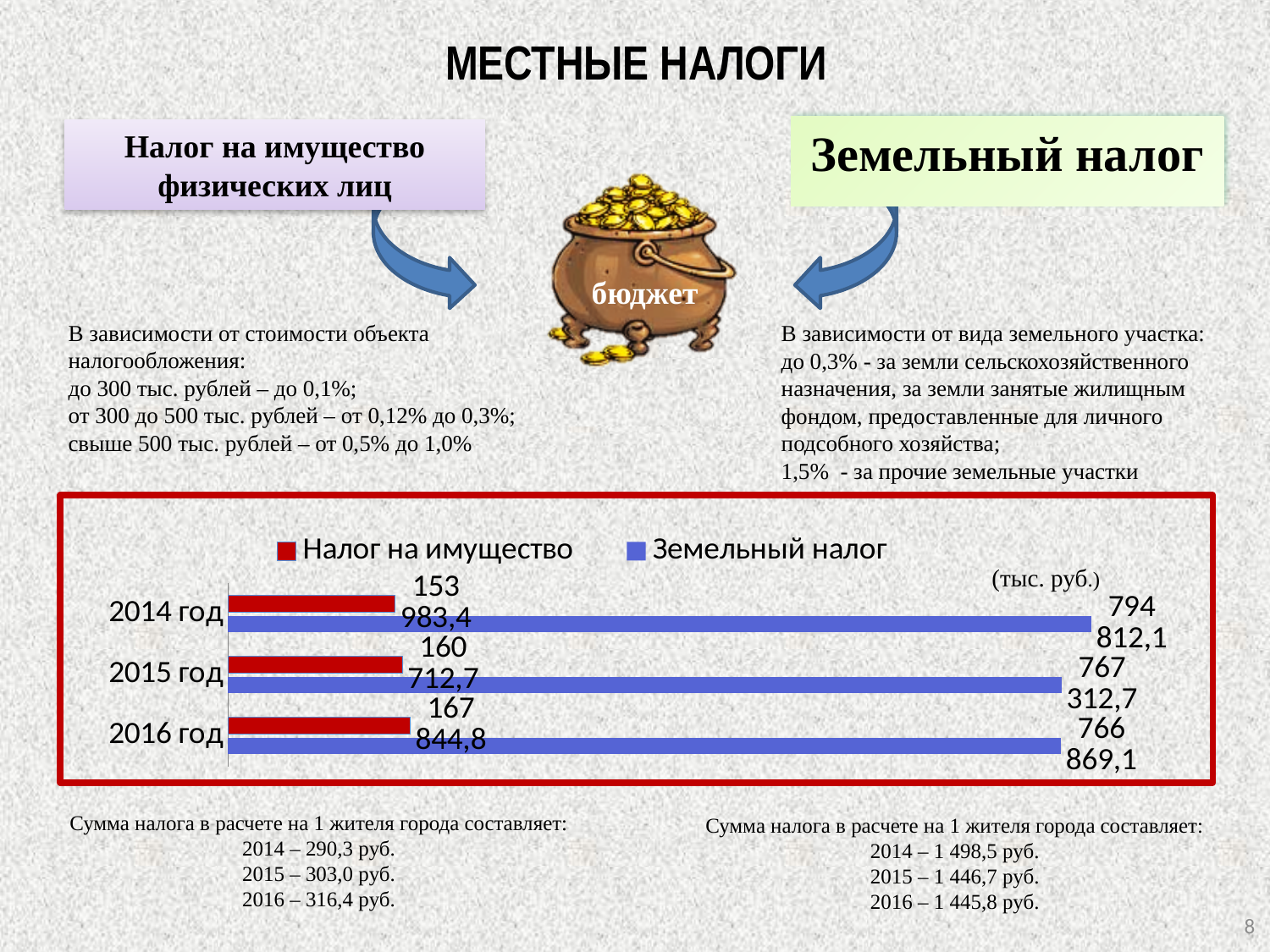
What is the difference between Налог на имущество in 2016 год and in 2014 год? 13 861,4 In which year is Налог на имущество the lowest? 2014 год What kind of chart is shown on the slide? bar chart In what units are the chart values given? тыс. руб. In which year is Земельный налог the highest? 2014 год How many series does the chart legend list? 2 For 2015 год, which is larger: Налог на имущество or Земельный налог? Земельный налог Does Налог на имущество rise or fall from 2014 год to 2016 год? rises How many years are shown on the chart? 3 What is the value of Налог на имущество for 2014 год? 153 983,4 What is the value of Земельный налог for 2015 год? 767 312,7 What is the value of Земельный налог for 2016 год? 766 869,1